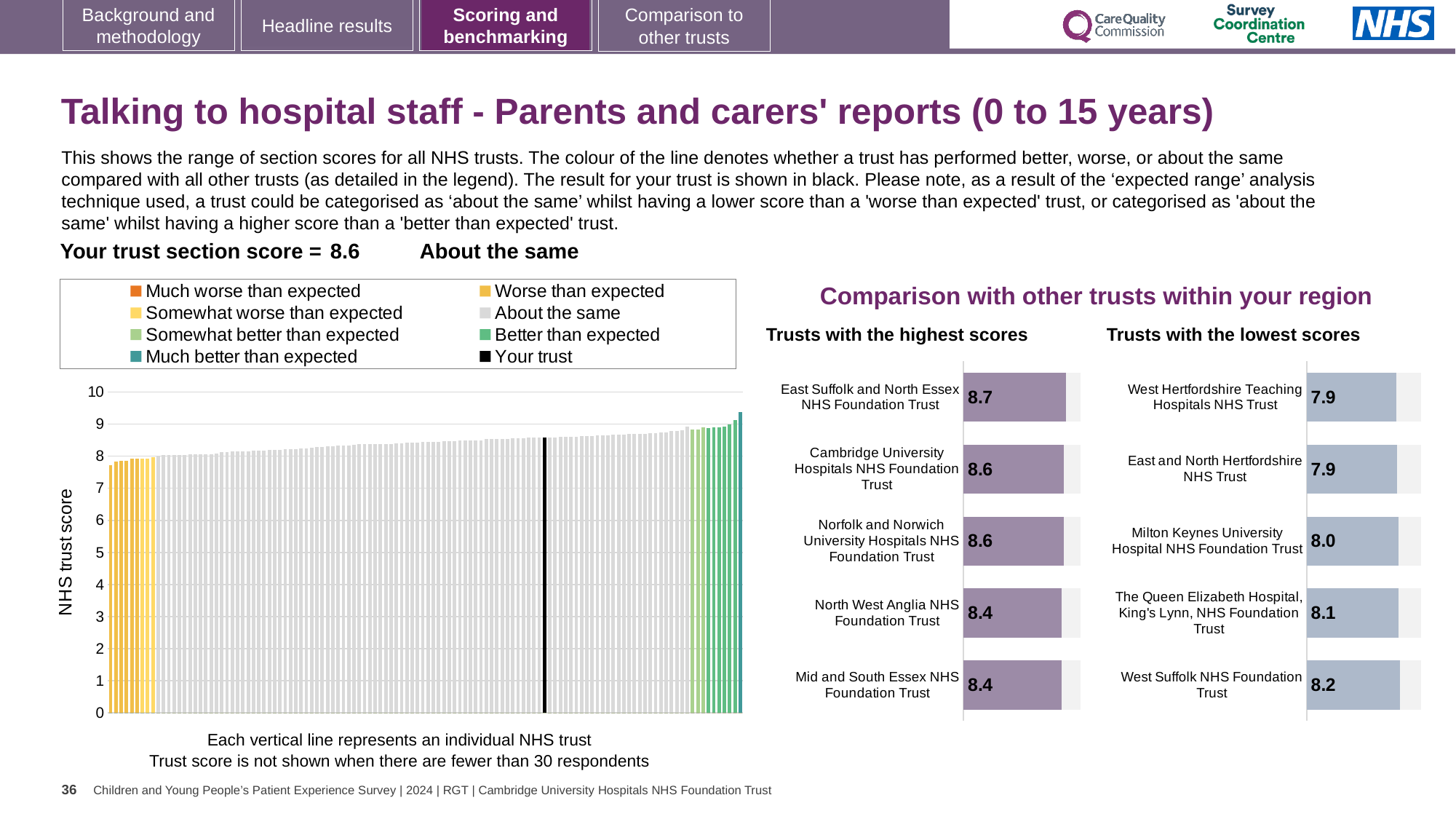
In the 'Trusts with the highest scores' chart, which has the larger score: North West Anglia NHS Foundation Trust or Cambridge University Hospitals NHS Foundation Trust? Cambridge University Hospitals NHS Foundation Trust How many entries does the legend of the NHS trust score chart on the left list? 8 How many trusts are listed in the 'Trusts with the highest scores' chart? 5 In the 'Trusts with the lowest scores' chart, what is the score for Milton Keynes University Hospital NHS Foundation Trust? 8.0 In the 'Trusts with the highest scores' chart, which trust has the highest score? East Suffolk and North Essex NHS Foundation Trust In the 'Trusts with the lowest scores' chart, which trust has the highest score shown? West Suffolk NHS Foundation Trust What kind of chart is the NHS trust score chart on the left of the slide? Bar chart In the 'Trusts with the highest scores' chart, what is the score for East Suffolk and North Essex NHS Foundation Trust? 8.7 In the 'Trusts with the highest scores' chart, what is the difference between the scores of East Suffolk and North Essex NHS Foundation Trust and Mid and South Essex NHS Foundation Trust? 0.3 In the NHS trust score chart on the left, is the value for the black 'Your trust' bar greater or less than 8? greater In the 'Trusts with the lowest scores' chart, what is the difference between the scores of West Suffolk NHS Foundation Trust and West Hertfordshire Teaching Hospitals NHS Trust? 0.3 In the NHS trust score chart on the left, do the values rise or fall from left to right along the x axis? Rise